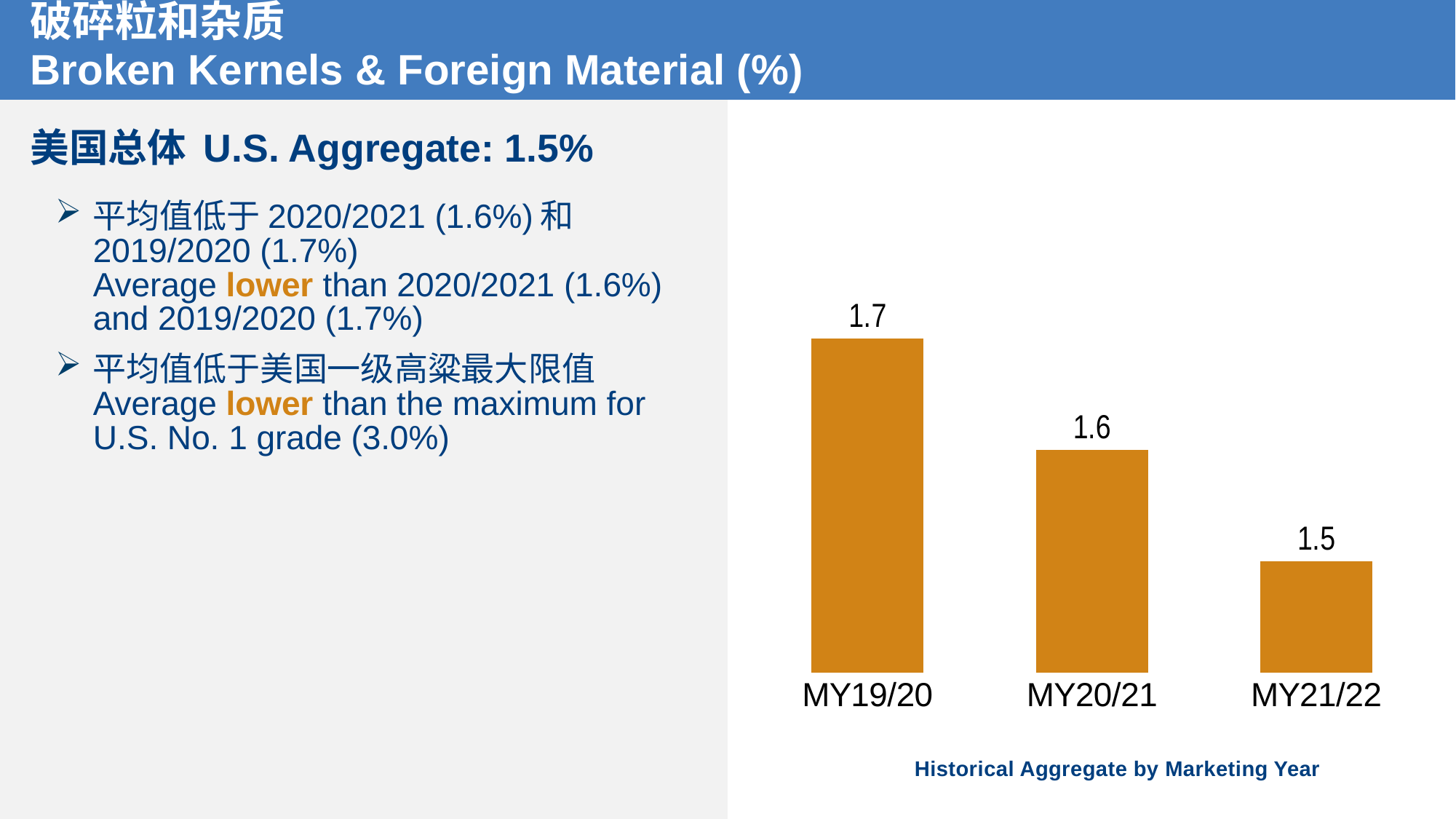
What is the caption shown below the chart? Historical Aggregate by Marketing Year Which marketing year has the lowest value? MY21/22 What is the value for MY19/20? 1.7 What is the value for MY20/21? 1.6 Do the values rise or fall from MY19/20 to MY21/22? Fall What is the difference between the values for MY20/21 and MY21/22? 0.1 Which is larger, the value for MY19/20 or the value for MY20/21? MY19/20 How many marketing years are shown in the chart? 3 What kind of chart is shown on the slide? Bar chart What is the difference between the values for MY19/20 and MY21/22? 0.2 Which marketing year has the highest value? MY19/20 What is the value for MY21/22? 1.5